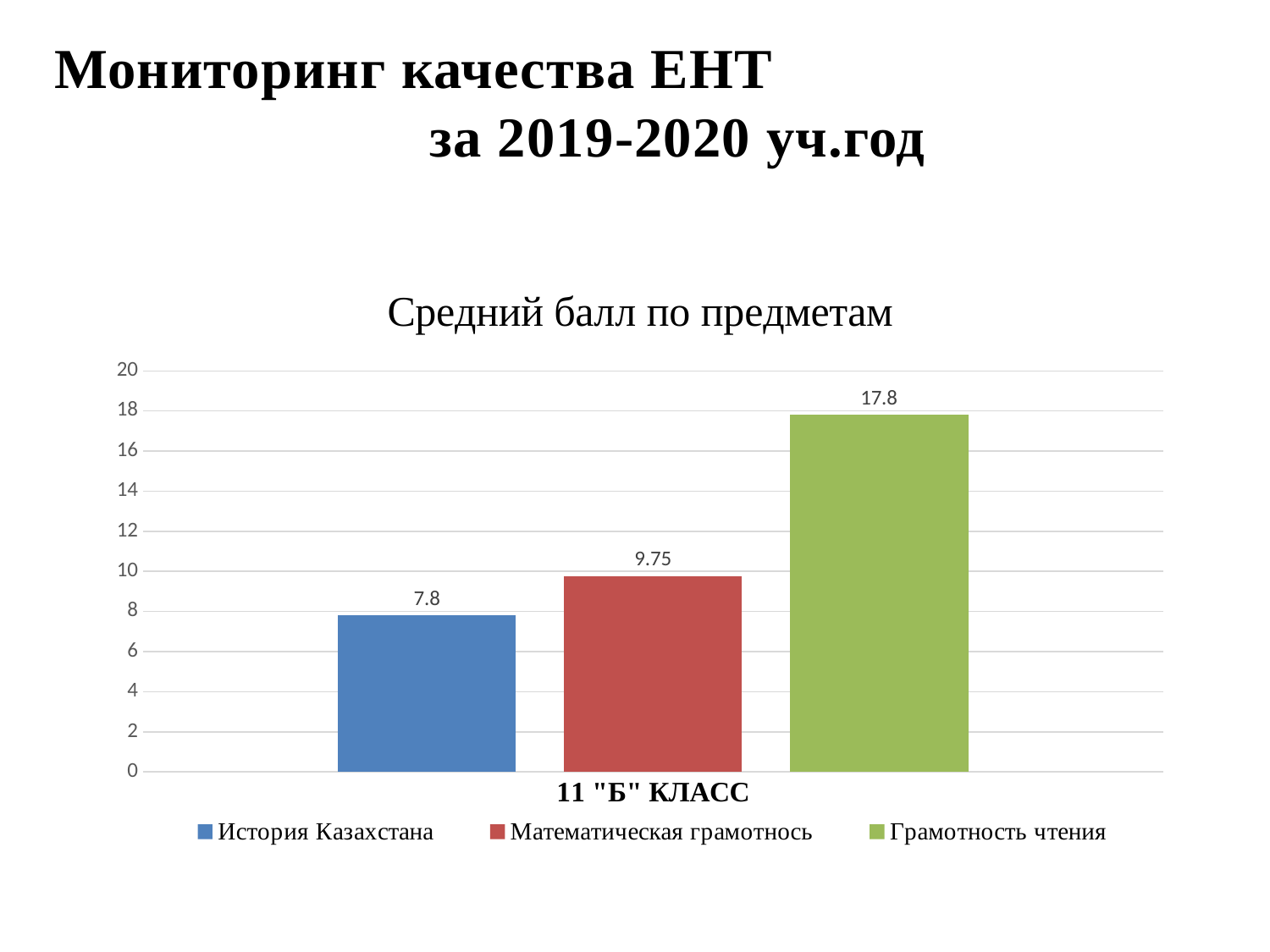
What is the title of the chart? Средний балл по предметам How many series does the legend list? 3 What is the average score for Математическая грамотнось? 9.75 Which is larger, the score for Математическая грамотнось or for История Казахстана? Математическая грамотнось What is the average score for Грамотность чтения? 17.8 Is the value for Грамотность чтения greater or less than 16? greater What is the difference between the scores for Математическая грамотнось and История Казахстана? 1.95 What is the difference between the scores for Грамотность чтения and История Казахстана? 10 What kind of chart is shown on the slide? bar chart Which subject has the highest average score? Грамотность чтения What is the average score for История Казахстана? 7.8 Which subject has the lowest average score? История Казахстана